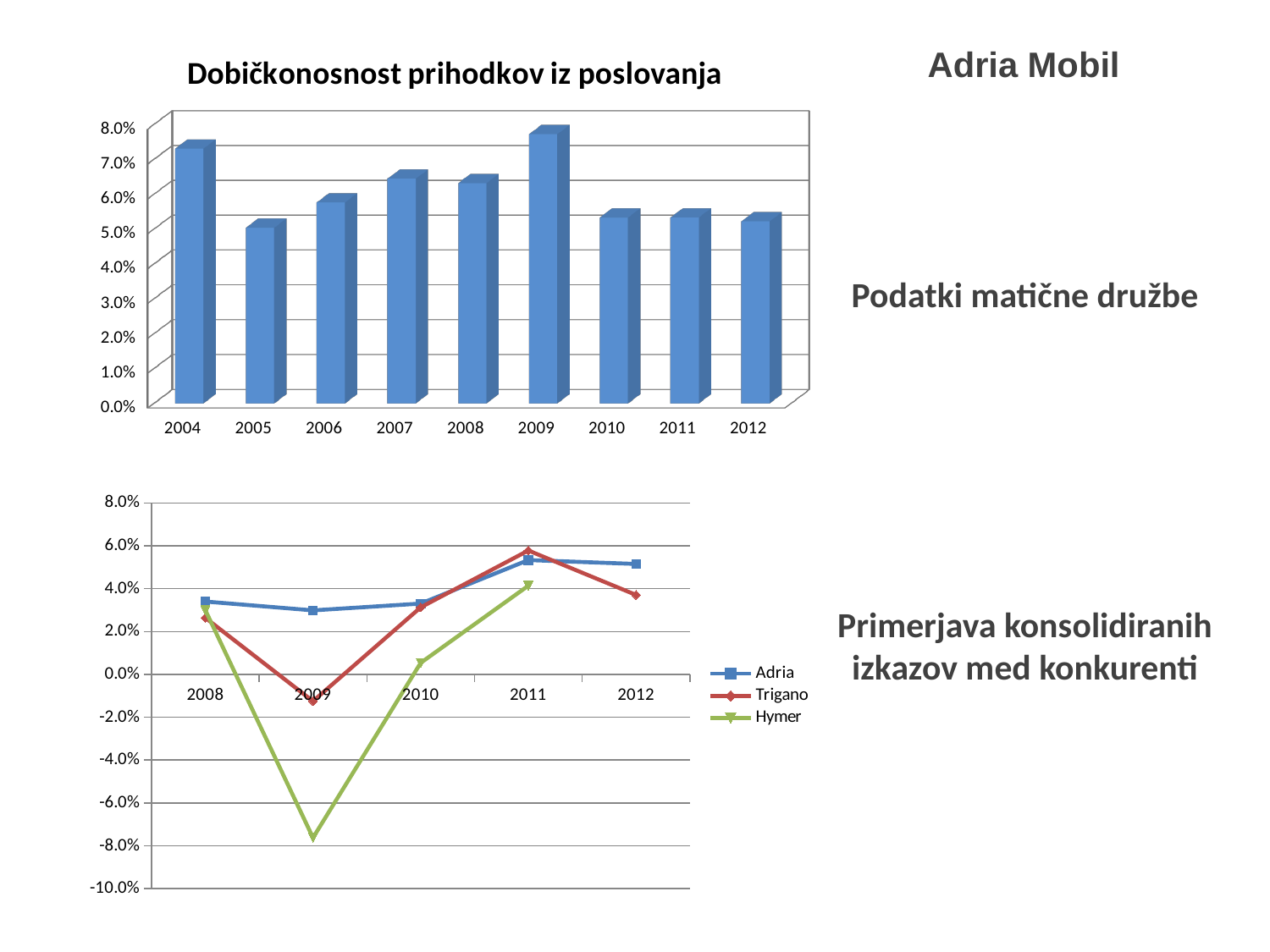
On the top chart 'Dobičkonosnost prihodkov iz poslovanja', which year has the lowest value? 2005 On the bottom line chart, is the value for Hymer in 2009 greater or less than -6.0%? less On the bottom line chart, how many series does the legend list? 3 On the bottom line chart, which is larger in 2012, Adria or Trigano? Adria On the top chart 'Dobičkonosnost prihodkov iz poslovanja', is the value for 2009 greater or less than 7.0%? greater On the top chart 'Dobičkonosnost prihodkov iz poslovanja', is the value for 2005 greater or less than 6.0%? less On the top chart 'Dobičkonosnost prihodkov iz poslovanja', how many years are shown on the x axis? 9 On the bottom line chart, does the Adria series rise or fall from 2009 to 2011? rise On the bottom line chart, which series has the lowest value in 2009? Hymer On the top chart 'Dobičkonosnost prihodkov iz poslovanja', which year has the highest value? 2009 What kind of chart is the top chart 'Dobičkonosnost prihodkov iz poslovanja'? bar chart